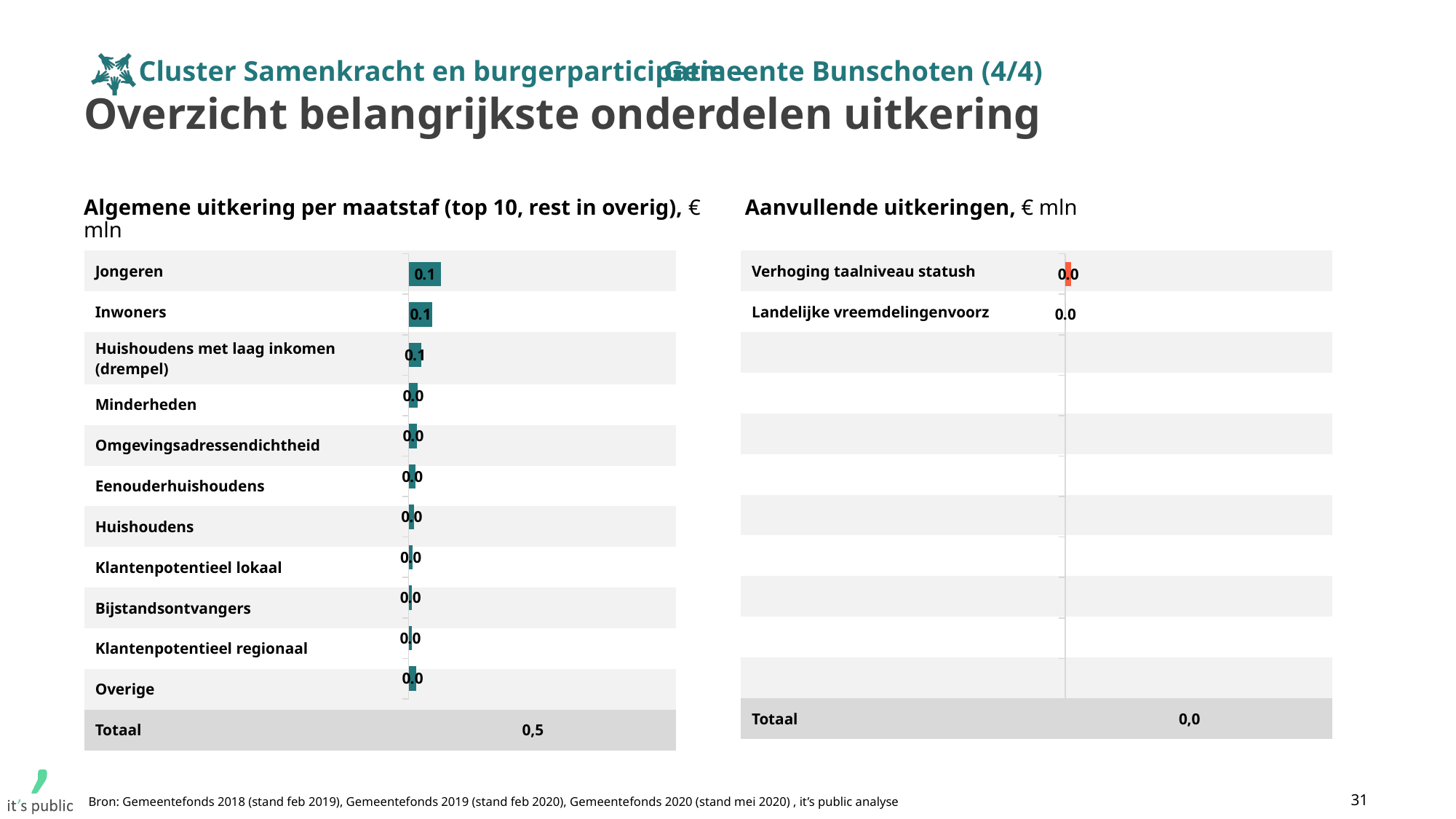
In the chart 'Algemene uitkering per maatstaf', what is the difference between the value for Inwoners and the value for Huishoudens? 0.1 In the chart 'Algemene uitkering per maatstaf', which category has the longest bar? Jongeren How many categories are shown in the chart 'Algemene uitkering per maatstaf'? 11 In the chart 'Algemene uitkering per maatstaf', what is the value for Minderheden? 0.0 In the chart 'Aanvullende uitkeringen', what is the value for Landelijke vreemdelingenvoorz? 0.0 In the chart 'Algemene uitkering per maatstaf', what is the value for Huishoudens met laag inkomen (drempel)? 0.1 What is the Totaal shown for the chart 'Algemene uitkering per maatstaf'? 0,5 What type of chart is the chart on the left of the slide? Bar chart What is the Totaal shown for the chart 'Aanvullende uitkeringen'? 0,0 How many categories are shown in the chart 'Aanvullende uitkeringen'? 2 In the chart 'Algemene uitkering per maatstaf', which is larger, the value for Jongeren or the value for Bijstandsontvangers? Jongeren In the chart 'Algemene uitkering per maatstaf', what is the value for Jongeren? 0.1